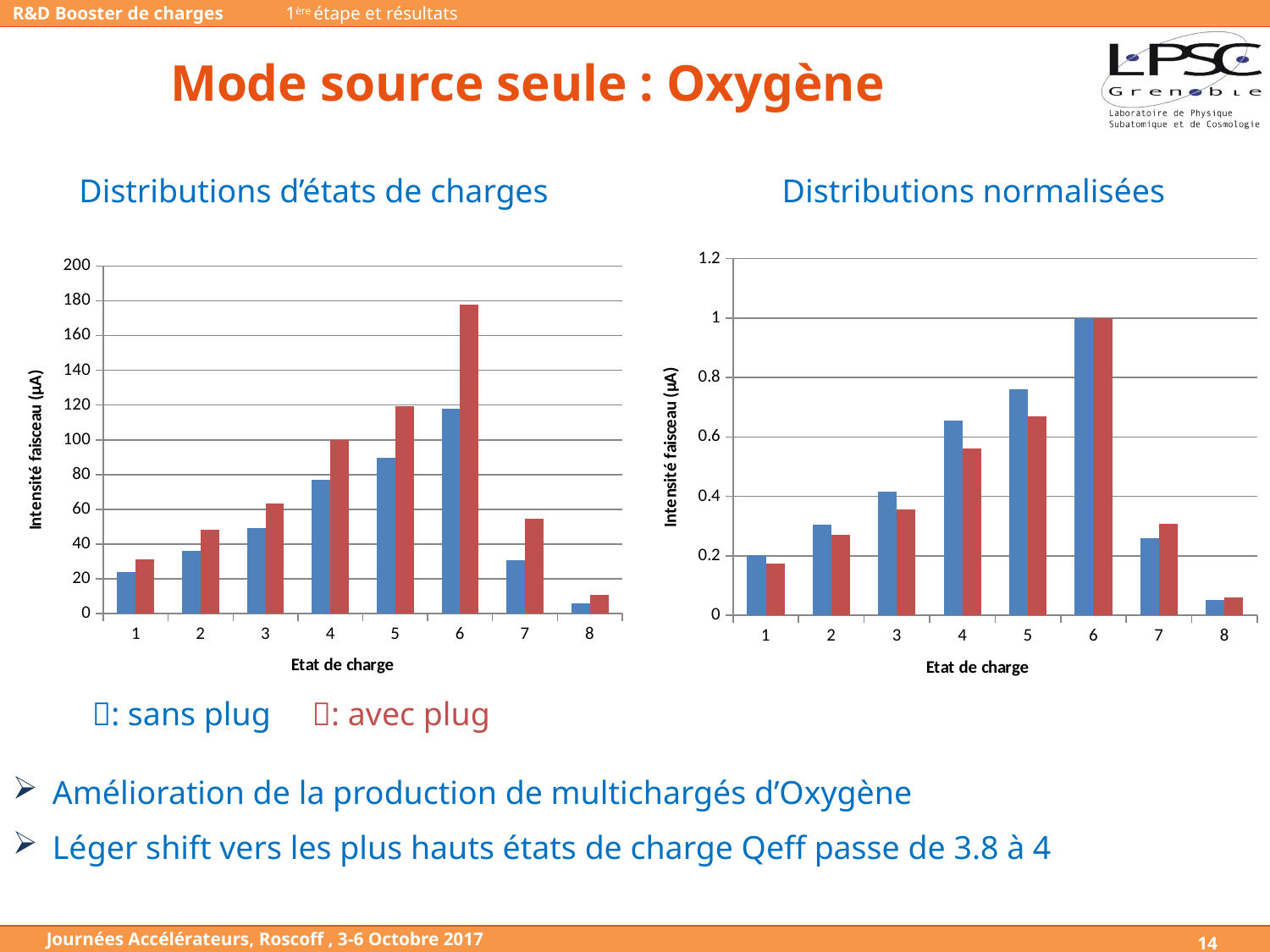
In the left chart 'Distributions d'états de charges', is the red (avec plug) value for charge state 6 greater or less than 160? greater In the left chart 'Distributions d'états de charges', how many charge states (Etat de charge) are shown on the x axis? 8 In the right chart 'Distributions normalisées', what is the value for charge state 6? 1 In the right chart 'Distributions normalisées', is the blue (sans plug) value for charge state 5 greater or less than 0.6? greater In the right chart 'Distributions normalisées', for charge state 4, which is larger: the blue (sans plug) bar or the red (avec plug) bar? blue (sans plug) In the left chart 'Distributions d'états de charges', is the blue (sans plug) value for charge state 1 greater or less than 40? less In the right chart 'Distributions normalisées', which charge state has the lowest bars? 8 What is the x-axis title of the left chart 'Distributions d'états de charges'? Etat de charge In the left chart 'Distributions d'états de charges', which charge state has the highest bar? 6 In the left chart 'Distributions d'états de charges', for charge state 5, which is larger: the blue (sans plug) bar or the red (avec plug) bar? red (avec plug) What kind of chart is the left chart titled 'Distributions d'états de charges'? bar chart